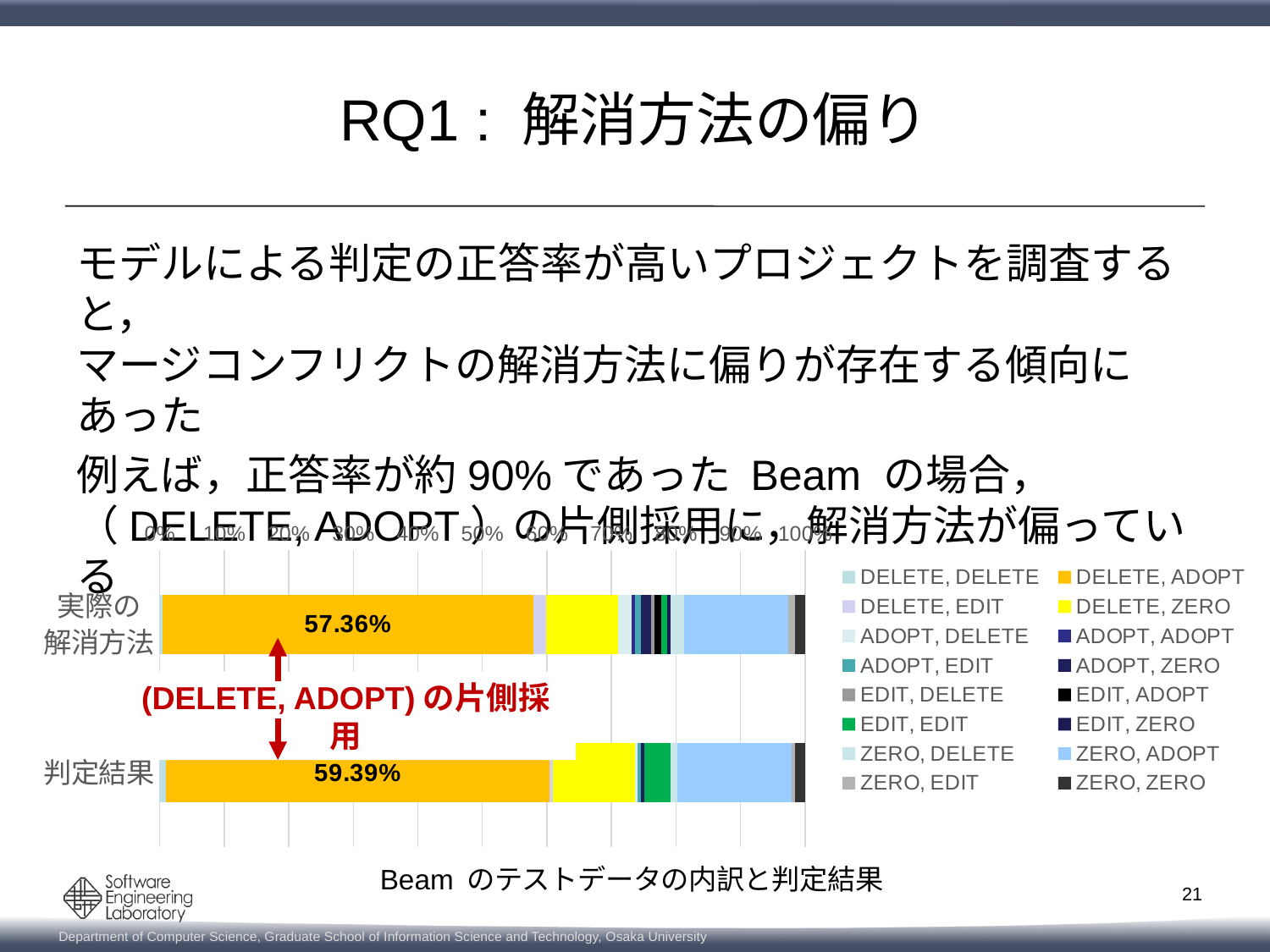
Which series takes up the largest portion of the 判定結果 bar? DELETE, ADOPT What is the value of the DELETE, ADOPT segment for 判定結果? 59.39% How many bars (categories) are plotted in the chart? 2 Is the DELETE, ADOPT share for 実際の解消方法 greater or less than 50%? greater What is the difference between the DELETE, ADOPT shares of 判定結果 and 実際の解消方法? 2.03% Is the DELETE, ZERO share for 判定結果 greater or less than 20%? less What kind of chart is shown on the slide? Stacked bar chart What is the value of the DELETE, ADOPT segment for 実際の解消方法? 57.36% How many series does the legend list? 16 What colour represents DELETE, ADOPT in the legend? Orange Which bar has the larger DELETE, ADOPT share, 実際の解消方法 or 判定結果? 判定結果 What is the caption written below the chart? Beam のテストデータの内訳と判定結果